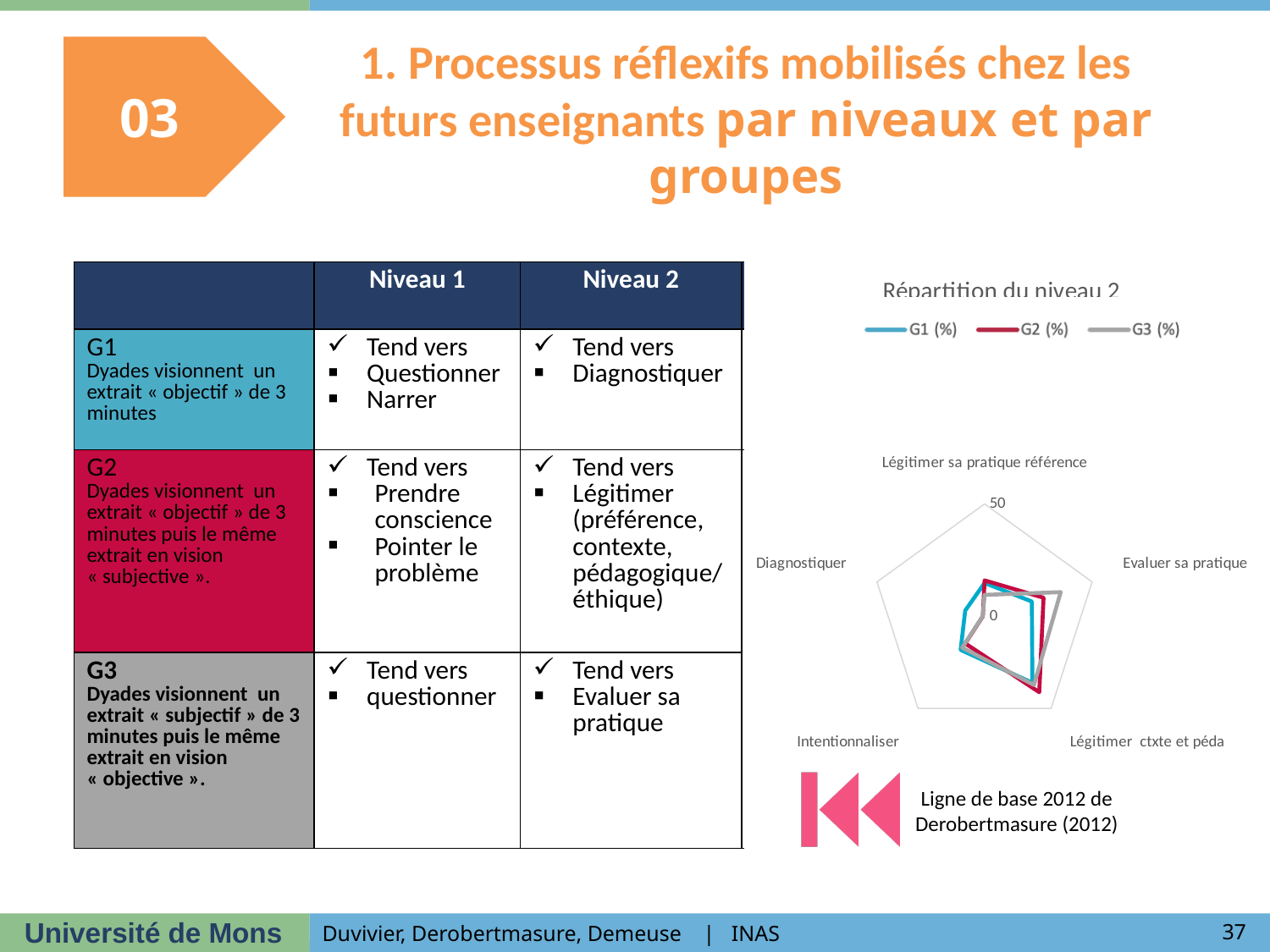
What kind of chart is shown on the right of the slide? radar chart How many categories (axes) does the radar chart have? 5 Is the value for G3 (%) on 'Evaluer sa pratique' greater or less than 50? less How many series does the chart legend list? 3 On 'Evaluer sa pratique', which series has the larger value, G1 (%) or G3 (%)? G3 (%) Is the value for G1 (%) on 'Intentionnaliser' greater or less than 50? less Is the value for G2 (%) on 'Légitimer ctxte et péda' greater or less than 50? less Which series is drawn in red on the radar chart? G2 (%) What is the title of the chart on the slide? Répartition du niveau 2